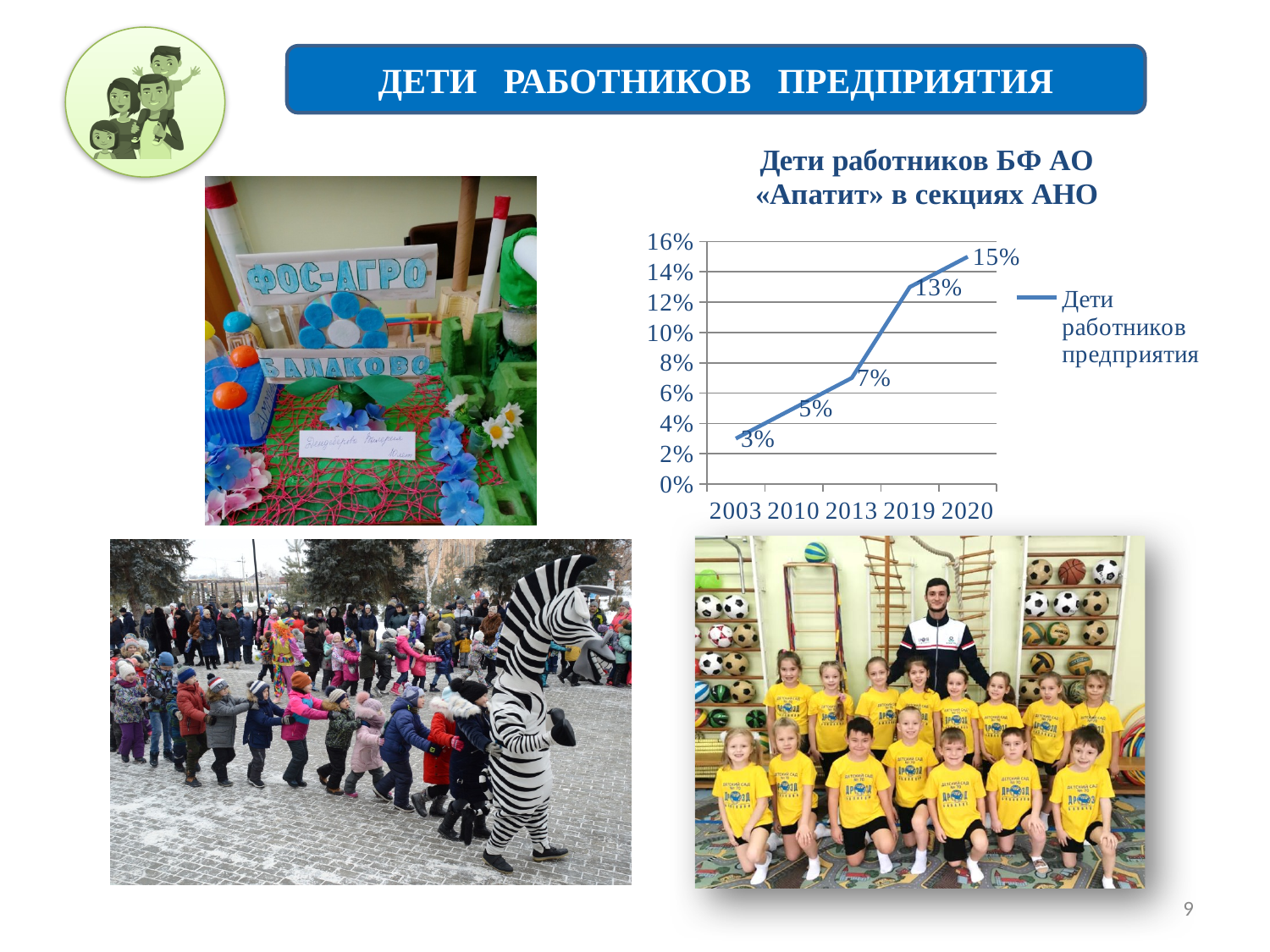
How many years are plotted on the chart? 5 Do the values rise or fall from 2003 to 2020? rise What value does the chart show for 2003? 3% How many series does the legend list? 1 What value does the chart show for 2020? 15% What kind of chart is shown on the slide? line chart Which is larger, the value for 2013 or the value for 2019? 2019 Which year has the lowest value on the chart? 2003 What is the difference between the values for 2019 and 2010? 8% Which year has the highest value on the chart? 2020 What value does the chart show for 2013? 7% What is the legend entry for the plotted series? Дети работников предприятия